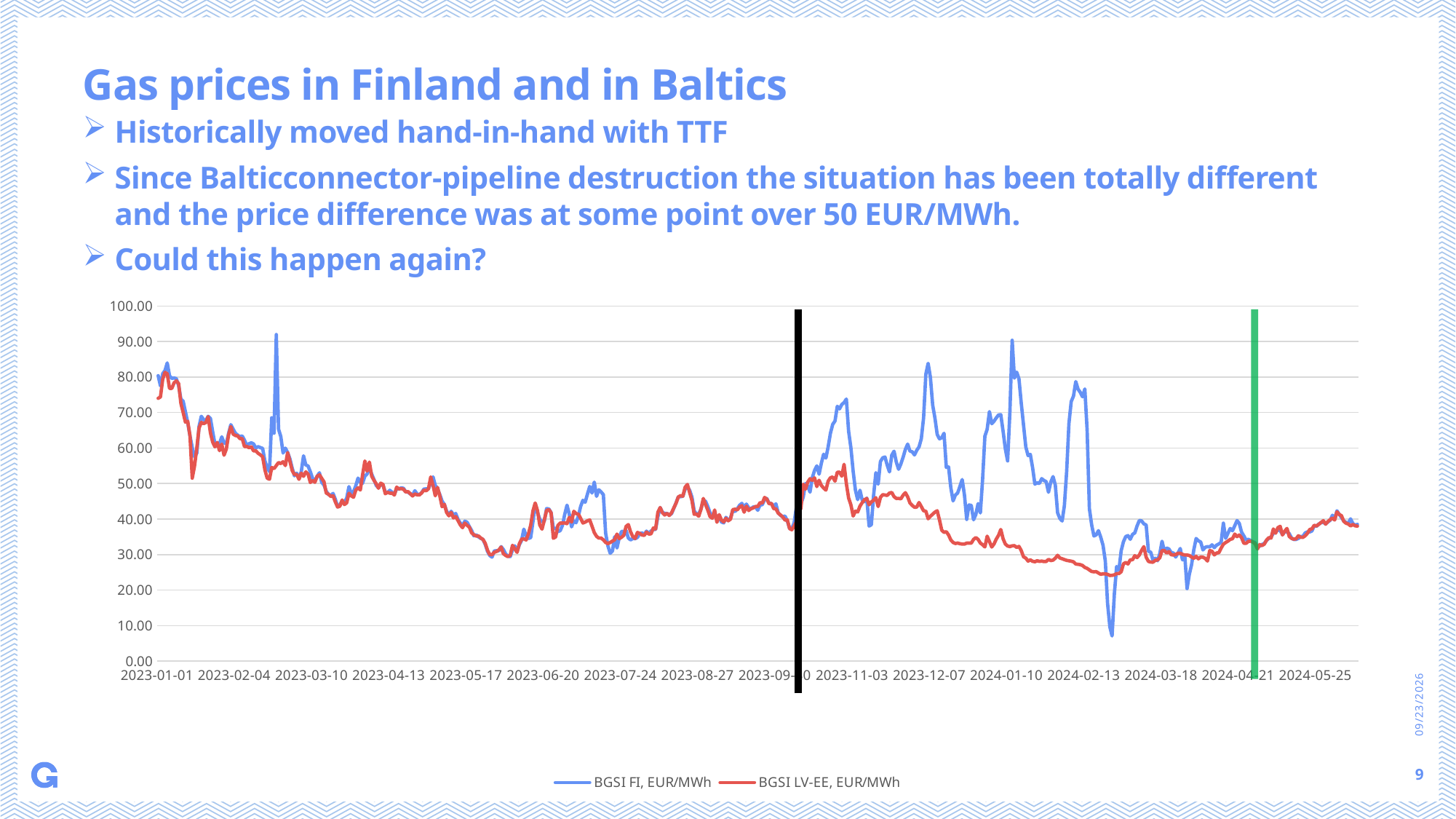
Which series reaches the lowest value anywhere on the chart? BGSI FI, EUR/MWh Is the peak value of BGSI FI, EUR/MWh around 2024-01-10 greater or less than 80? greater How many series does the chart legend list? 2 What colour is the BGSI FI, EUR/MWh line? Blue What is the highest value shown on the chart's vertical axis? 100.00 Around 2023-12-07, which series has the higher value, BGSI FI or BGSI LV-EE? BGSI FI, EUR/MWh What kind of chart is shown on the slide? Line chart Do the values of BGSI LV-EE, EUR/MWh generally rise or fall between 2023-01-01 and 2023-05-17? Fall Is the value of BGSI LV-EE, EUR/MWh around 2024-02-13 greater or less than 30? less What are the two series named in the chart legend? BGSI FI, EUR/MWh and BGSI LV-EE, EUR/MWh Which series reaches the highest value anywhere on the chart? BGSI FI, EUR/MWh Is the lowest value of BGSI FI, EUR/MWh around 2024-02-13 greater or less than 10? less